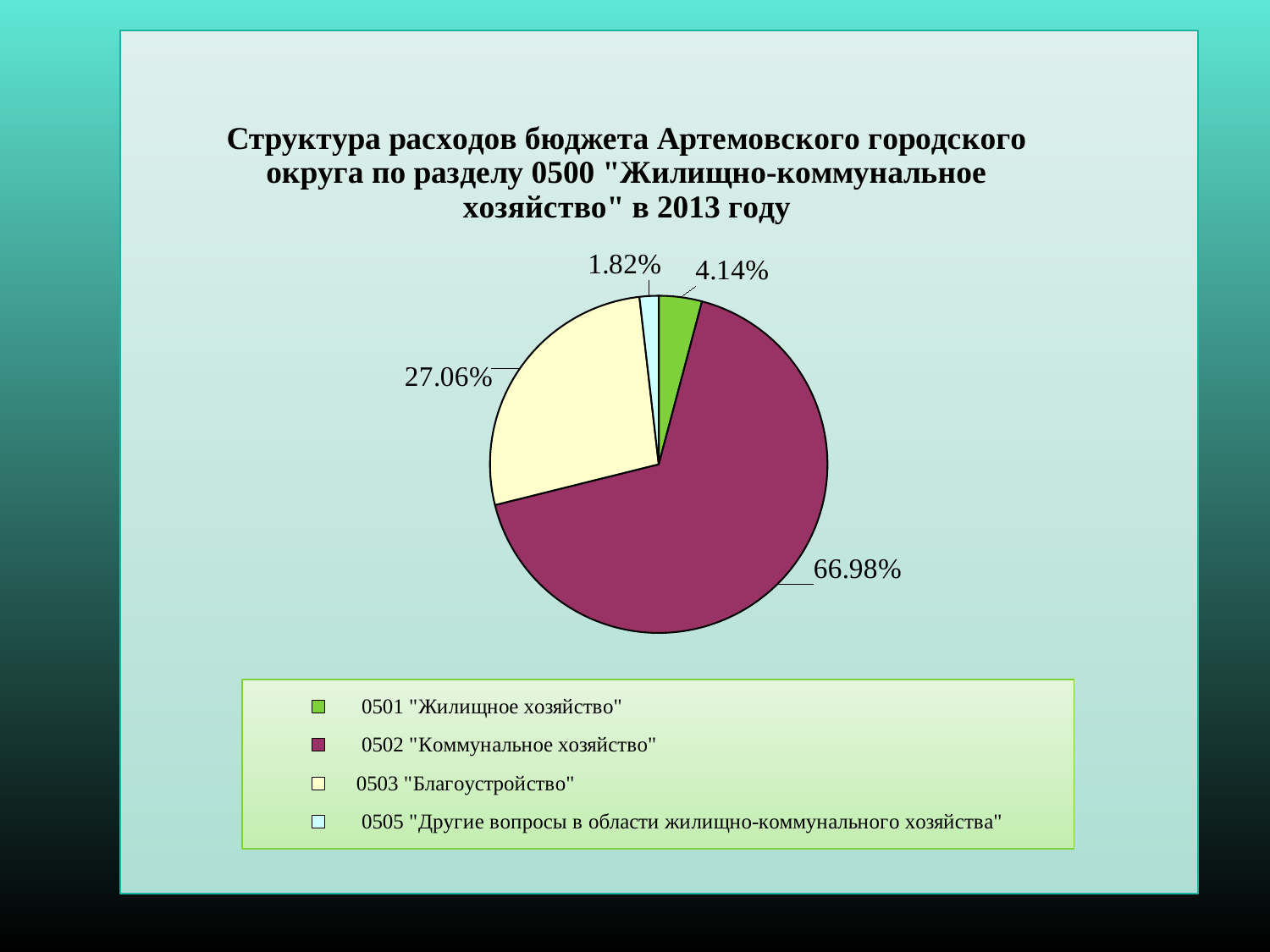
How many categories does the pie chart have? 4 What share of the pie does 0505 "Другие вопросы в области жилищно-коммунального хозяйства" have? 1.82% What share of the pie does 0501 "Жилищное хозяйство" have? 4.14% What share of the pie does 0503 "Благоустройство" have? 27.06% Which year does the chart title refer to? 2013 Which category has the smallest slice of the pie? 0505 "Другие вопросы в области жилищно-коммунального хозяйства" What share of the pie does 0502 "Коммунальное хозяйство" have? 66.98% Which category has the largest slice of the pie? 0502 "Коммунальное хозяйство" What colour is the slice for 0503 "Благоустройство"? light yellow What kind of chart is shown on the slide? pie chart Which is larger, the share of 0501 "Жилищное хозяйство" or the share of 0505 "Другие вопросы в области жилищно-коммунального хозяйства"? 0501 "Жилищное хозяйство" What is the difference in percentage points between the shares of 0502 "Коммунальное хозяйство" and 0503 "Благоустройство"? 39.92